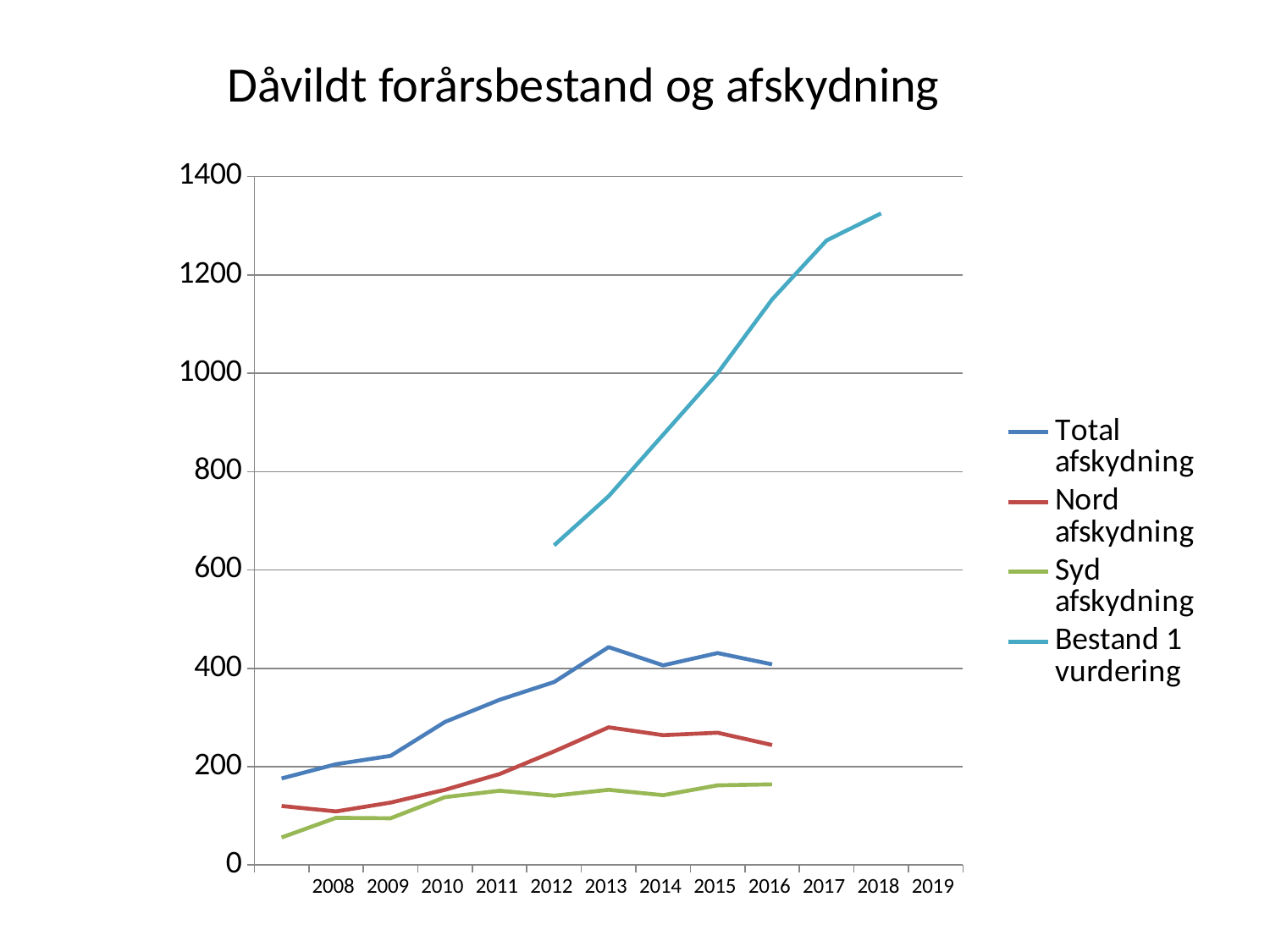
Is the value for Bestand 1 vurdering in 2012 greater or less than 800? less What kind of chart is shown on the slide? line chart Is the value for Nord afskydning in 2013 greater or less than 200? greater Which series is drawn in red? Nord afskydning What is the title of the chart? Dåvildt forårsbestand og afskydning Is the value for Syd afskydning in 2016 greater or less than 200? less Which series has the highest value in 2016? Bestand 1 vurdering Which series has the lowest value in 2013? Syd afskydning Does the Bestand 1 vurdering series rise or fall from 2012 to 2018? rise How many series does the legend list? 4